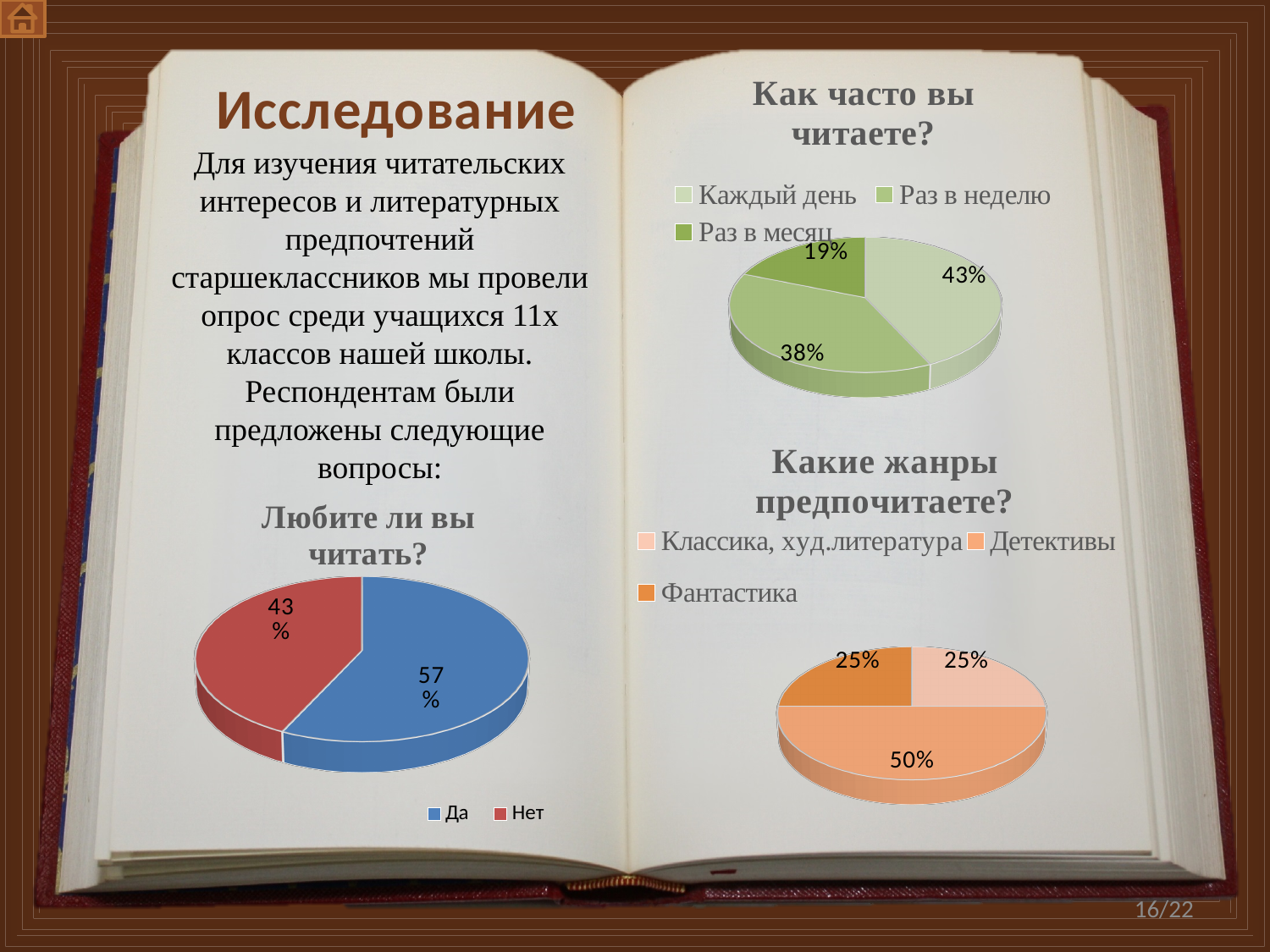
On the chart 'Как часто вы читаете?', how many categories does the legend list? 3 On the chart 'Какие жанры предпочитаете?', which genre has the largest share? Детективы On the chart 'Любите ли вы читать?', what is the difference between the 'Да' and 'Нет' shares? 14% What type of chart is 'Какие жанры предпочитаете?'? Pie chart On the chart 'Какие жанры предпочитаете?', what share of respondents prefer 'Детективы'? 50% On the chart 'Как часто вы читаете?', what share of respondents read 'Каждый день'? 43% On the chart 'Какие жанры предпочитаете?', which is larger: the share for 'Детективы' or for 'Фантастика'? Детективы How many charts are shown on the slide? 3 On the chart 'Как часто вы читаете?', what share of respondents read 'Раз в месяц'? 19% On the chart 'Как часто вы читаете?', which category has the smallest share? Раз в месяц On the chart 'Любите ли вы читать?', what share of respondents answered 'Да'? 57% On the chart 'Любите ли вы читать?', what share of respondents answered 'Нет'? 43%